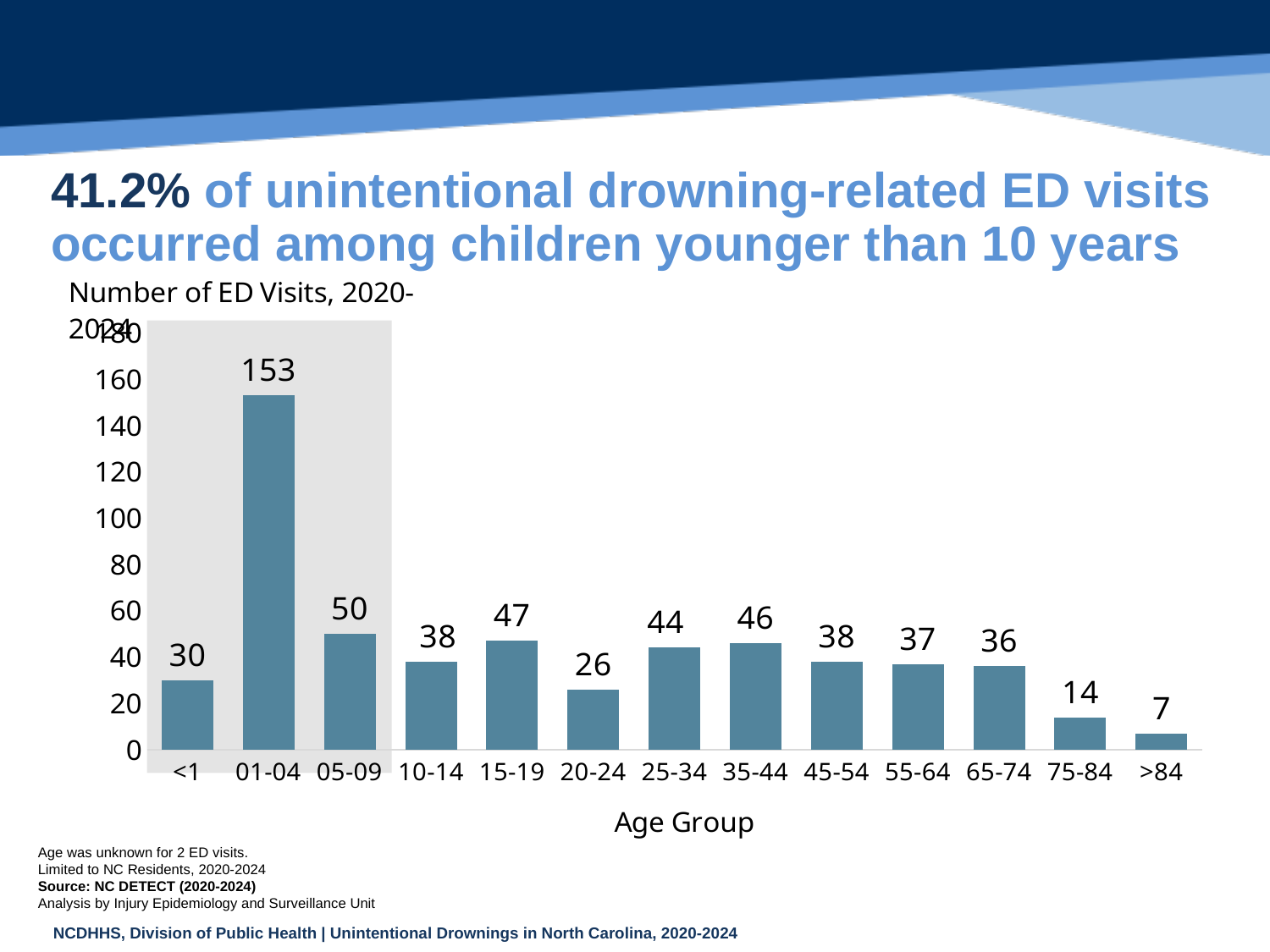
Which age group has the highest number of ED visits? 01-04 What is the difference in ED visits between the 01-04 and 05-09 age groups? 103 What kind of chart is shown on the slide? bar chart What is the number of ED visits for the 20-24 age group? 26 What is the label of the x axis? Age Group What is the number of ED visits for the >84 age group? 7 Which age group has the lowest number of ED visits? >84 What is the number of ED visits for the 01-04 age group? 153 Which age group has more ED visits, 15-19 or 25-34? 15-19 How many age groups are shown on the x axis? 13 What is the total number of ED visits for the <1, 01-04 and 05-09 age groups combined? 233 Is the value for the 75-84 age group greater or less than 20? less